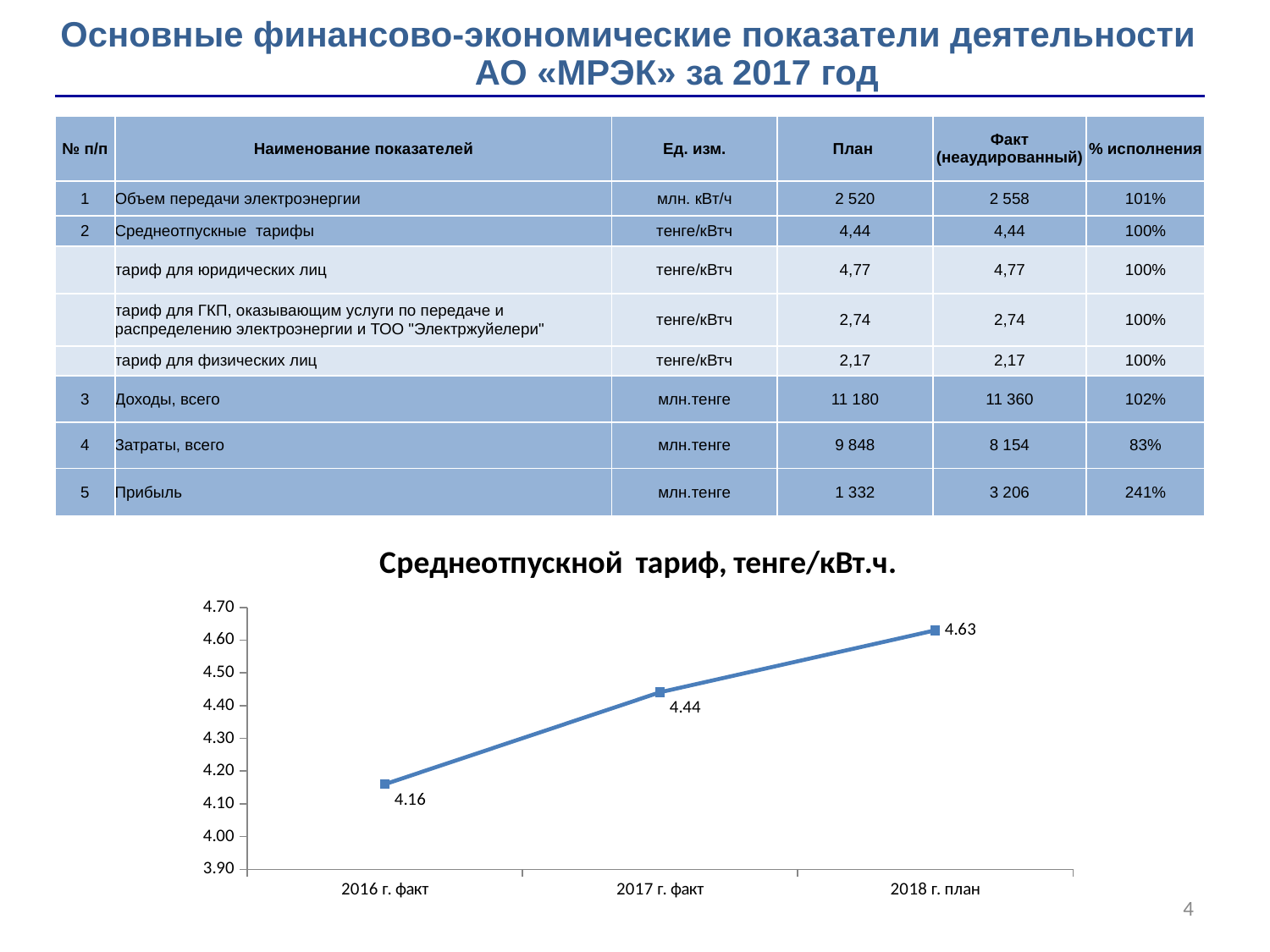
What is the difference between the values for 2018 г. план and 2017 г. факт? 0.19 What is the value for 2017 г. факт in the chart? 4.44 Do the values rise or fall from 2016 г. факт to 2018 г. план? rise Which is larger, the value for 2016 г. факт or the value for 2018 г. план? 2018 г. план Is the value for 2016 г. факт greater or less than 4.20? less What kind of chart is shown on the slide? line chart What is the value for 2016 г. факт in the chart? 4.16 Which category has the lowest value in the chart? 2016 г. факт What is the value for 2018 г. план in the chart? 4.63 What is the difference between the values for 2017 г. факт and 2016 г. факт? 0.28 How many data points are plotted in the chart? 3 Which category has the highest value in the chart? 2018 г. план